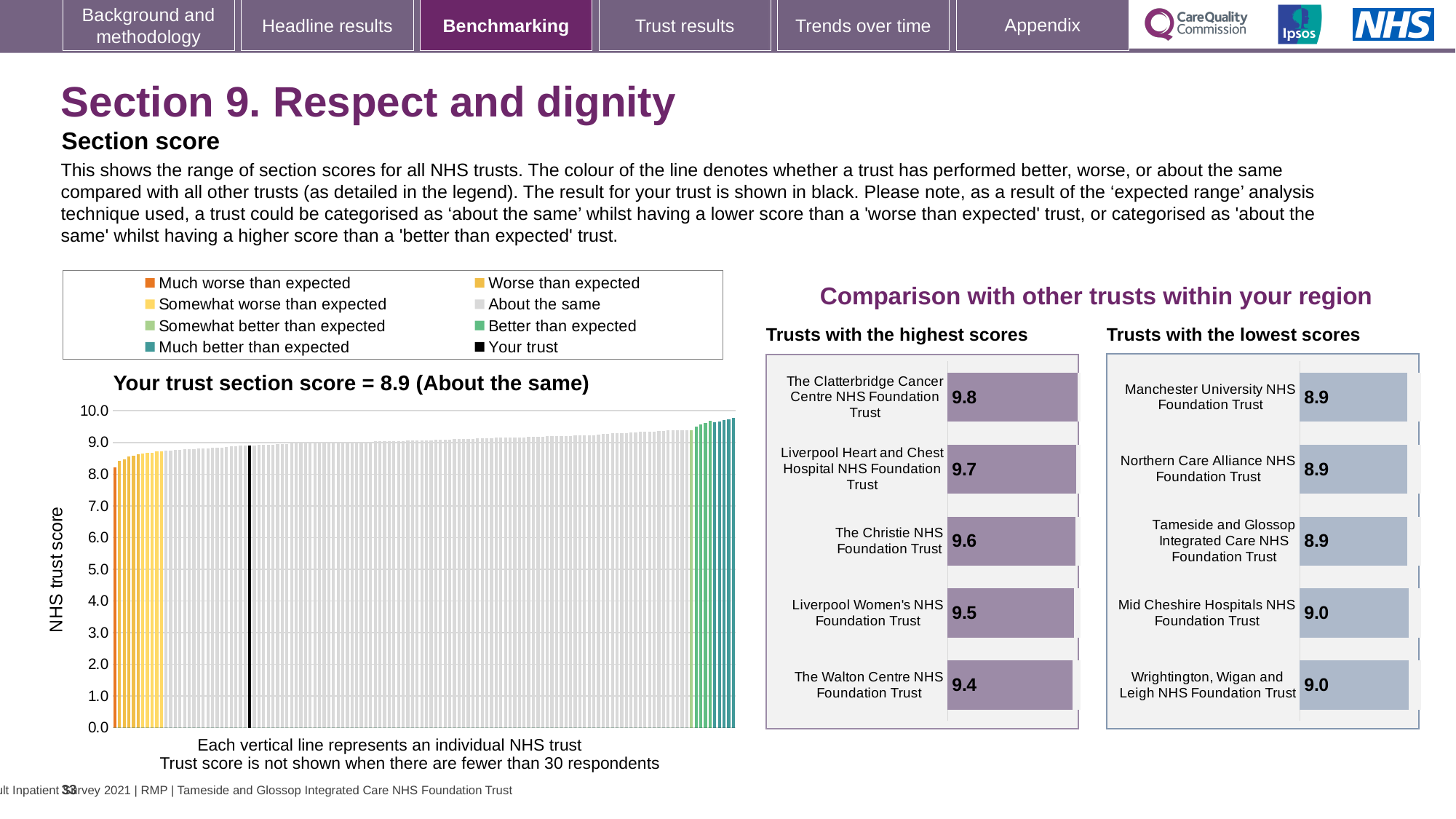
In the 'Trusts with the lowest scores' chart, what is the score for Mid Cheshire Hospitals NHS Foundation Trust? 9.0 In the main chart on the left, do the trust scores rise or fall from left to right along the x axis? Rise In the 'Trusts with the lowest scores' chart, what is the score for Northern Care Alliance NHS Foundation Trust? 8.9 In the 'Trusts with the highest scores' chart, what is the score for The Clatterbridge Cancer Centre NHS Foundation Trust? 9.8 In the 'Trusts with the highest scores' chart, what is the difference between the scores of The Clatterbridge Cancer Centre NHS Foundation Trust and The Walton Centre NHS Foundation Trust? 0.4 How many trusts are shown in the 'Trusts with the lowest scores' chart? 5 In the 'Trusts with the highest scores' chart, which trust has the highest score? The Clatterbridge Cancer Centre NHS Foundation Trust In the 'Trusts with the highest scores' chart, what is the score for The Walton Centre NHS Foundation Trust? 9.4 According to the title of the main chart on the left, what is your trust's section score? 8.9 (About the same) What type of chart is the main chart on the left showing the range of section scores for all NHS trusts? Bar chart In the 'Trusts with the highest scores' chart, which has the larger score: The Christie NHS Foundation Trust or Liverpool Women's NHS Foundation Trust? The Christie NHS Foundation Trust How many entries does the legend above the main chart on the left list? 8